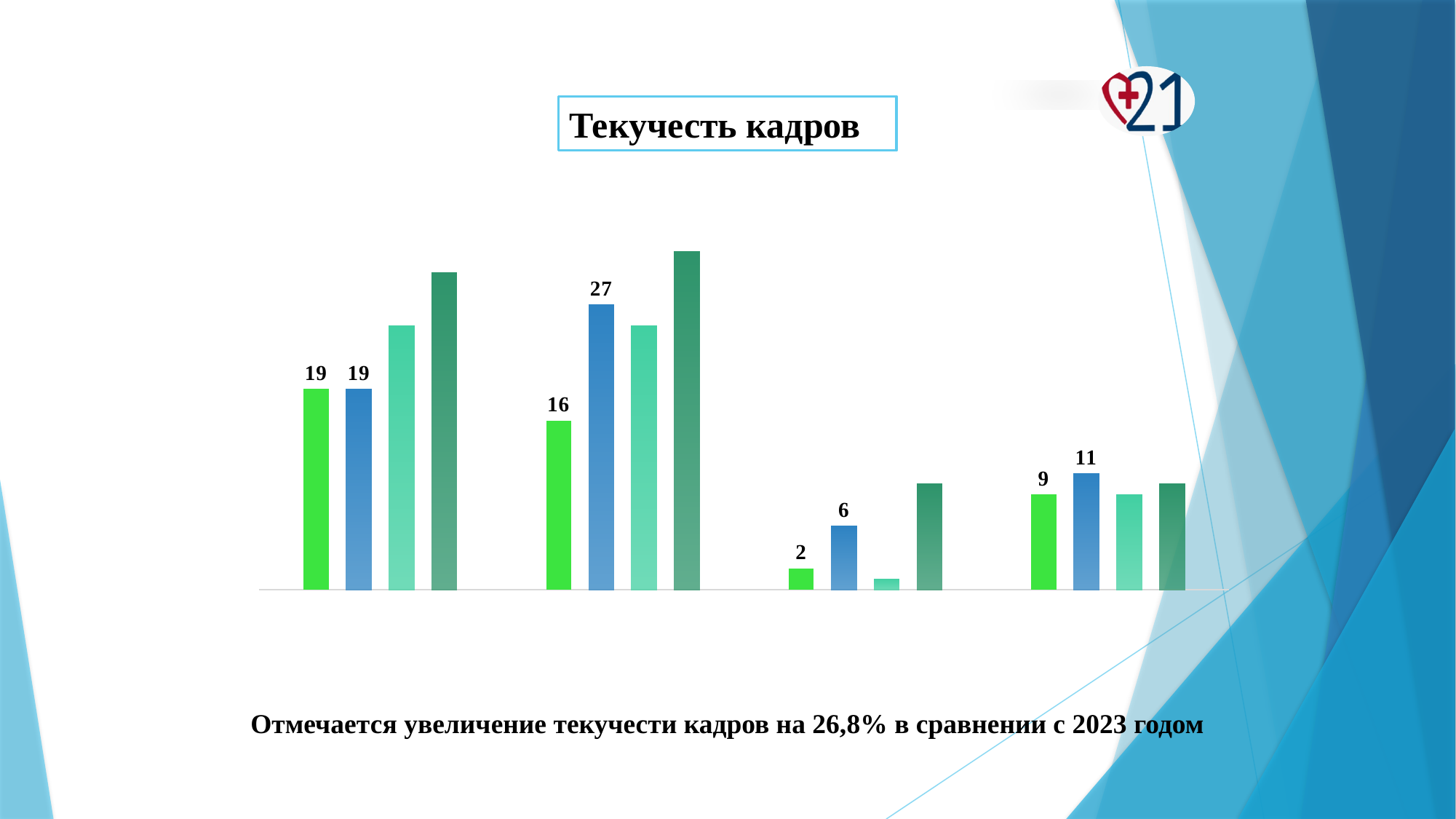
What kind of chart is shown on the slide? bar chart What is the value of the bright green bar in the third group from the left? 2 How many bars are there in each group? 4 In the second group from the left, what is the difference between the blue bar (27) and the bright green bar (16)? 11 How many groups of bars does the chart contain? 4 What is the value of the bright green bar in the first (leftmost) group? 19 What is the title of the chart? Текучесть кадров What is the value of the blue bar in the fourth (rightmost) group? 11 What is the value of the blue bar in the second group from the left? 27 Which is larger: the bright green bar in the first group or the bright green bar in the fourth group? the first group Which group of bars contains the tallest bar on the chart? the second group from the left In the third group from the left, what is the difference between the blue bar (6) and the bright green bar (2)? 4